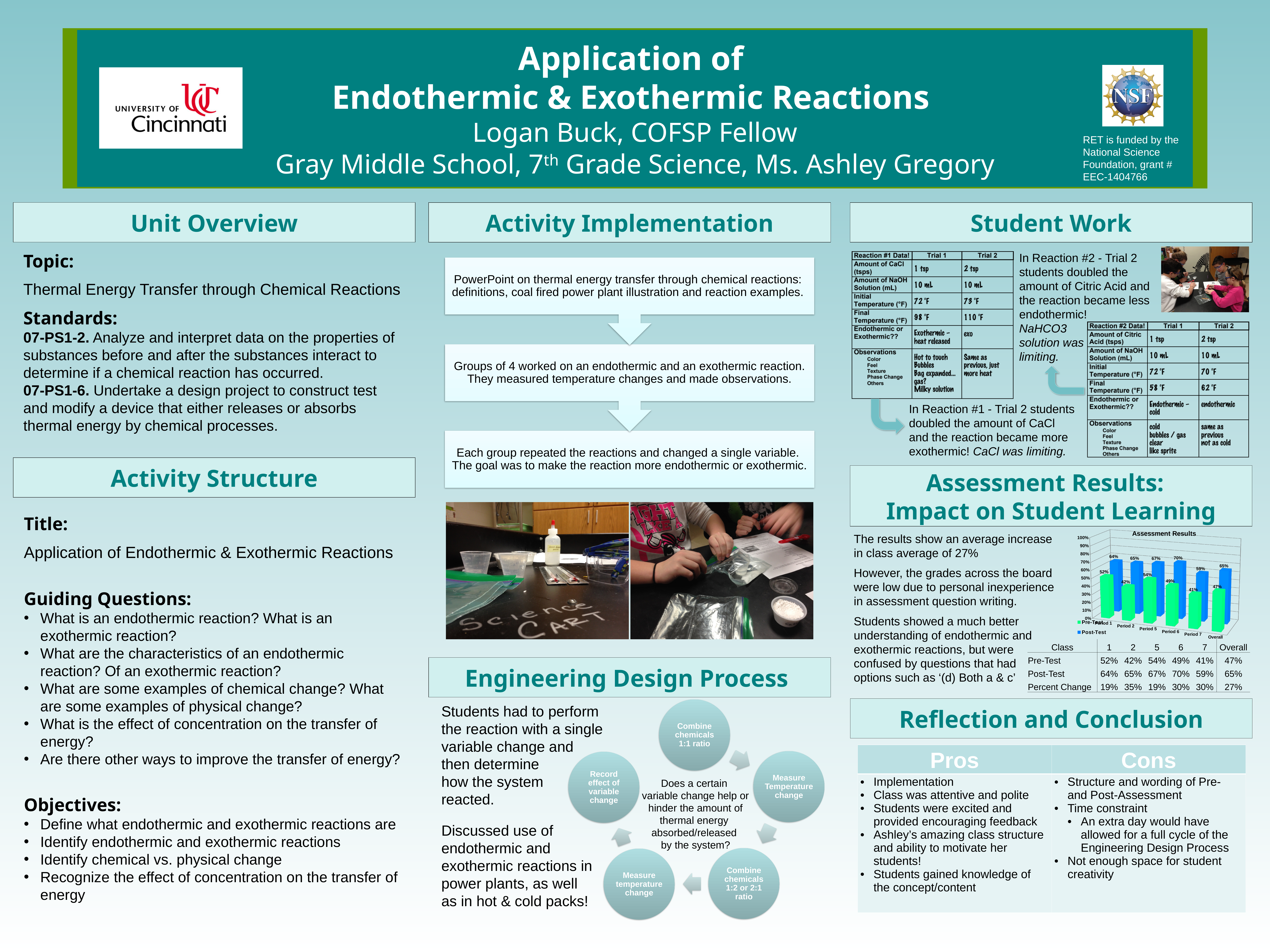
How many series does the legend of the Assessment Results chart list? 2 What is the Post-Test value for Period 6? 70% What is the Overall Pre-Test value? 47% Which category has the lowest Pre-Test value? Period 7 Which category has the highest Post-Test value? Period 6 What kind of chart is the Assessment Results chart? bar chart How many categories are shown on the x axis of the Assessment Results chart? 6 What is the difference between the Post-Test and Pre-Test values for Period 2? 23% Is the Post-Test value for Period 7 greater or less than 50%? greater What is the title of the chart? Assessment Results Which is larger, the Pre-Test value for Period 5 or the Pre-Test value for Period 2? Period 5 What is the Pre-Test value for Period 7? 41%